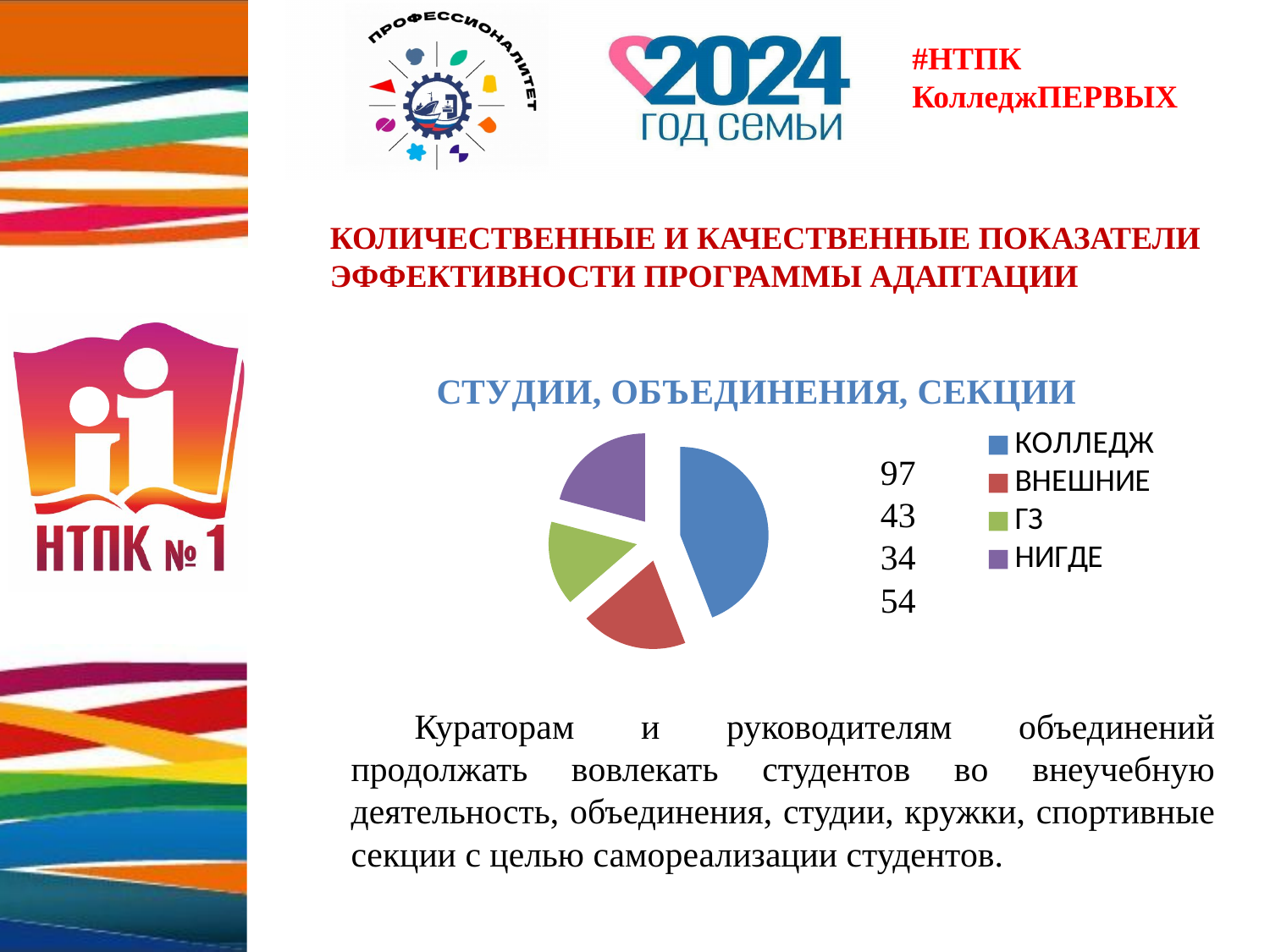
Which category has the smallest slice in the pie chart? ГЗ Which is larger in the pie chart, ВНЕШНИЕ or НИГДЕ? НИГДЕ How many slices does the pie chart have? 4 What value is shown for ВНЕШНИЕ in the pie chart? 43 How many categories does the legend of the pie chart list? 4 Which category has the largest slice in the pie chart? КОЛЛЕДЖ What value is shown for КОЛЛЕДЖ in the pie chart? 97 What is the difference between the values for КОЛЛЕДЖ and НИГДЕ? 43 What value is shown for ГЗ in the pie chart? 34 What value is shown for НИГДЕ in the pie chart? 54 What kind of chart is shown on the slide? pie chart What is the title of the chart on the slide? СТУДИИ, ОБЪЕДИНЕНИЯ, СЕКЦИИ